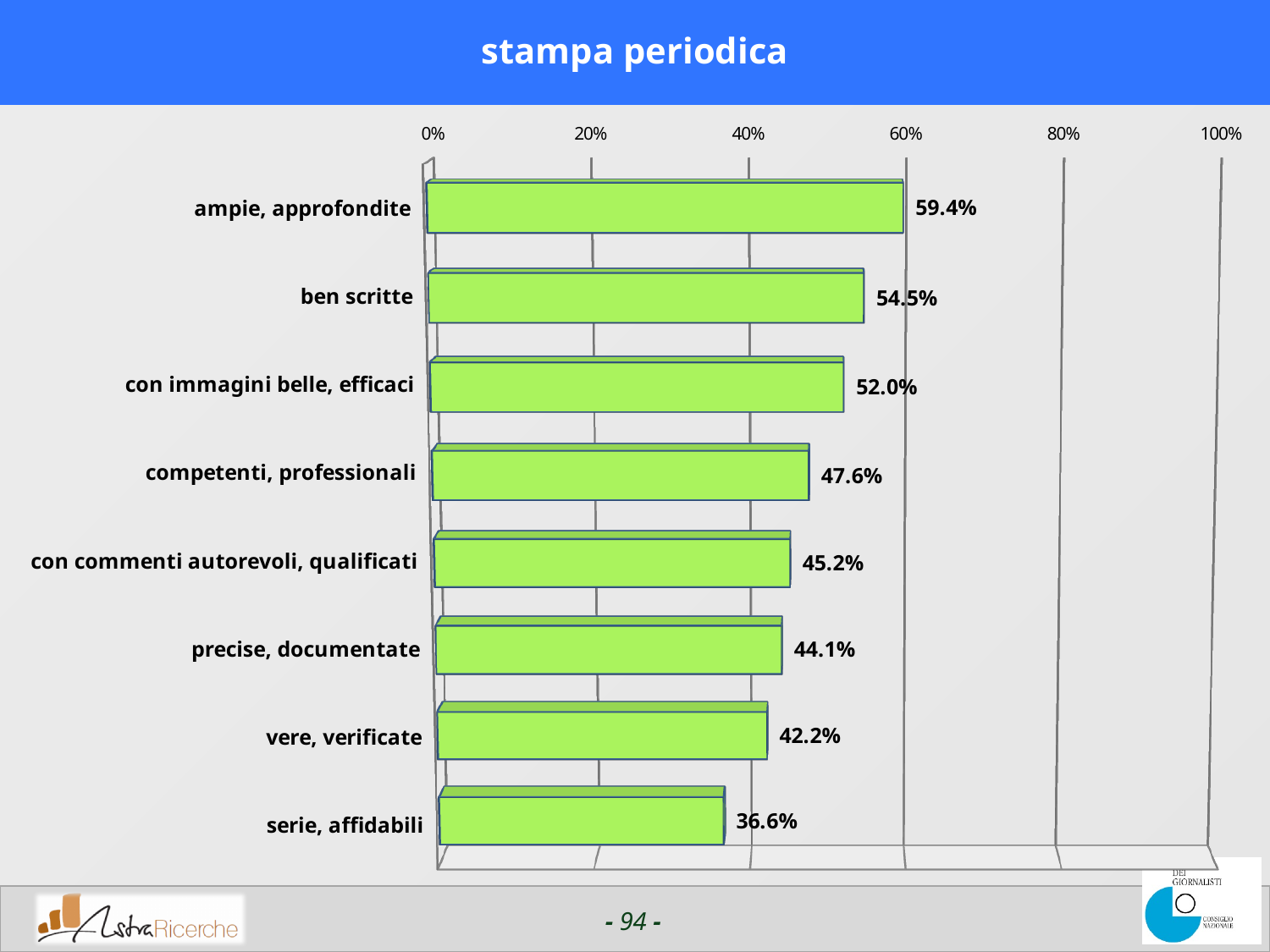
What is the value for "serie, affidabili"? 36.6% What is the difference between the values for "ben scritte" and "vere, verificate"? 12.3% Which category has the highest value? ampie, approfondite Which is larger, the value for "competenti, professionali" or the value for "con commenti autorevoli, qualificati"? competenti, professionali What is the title of the chart? stampa periodica Is the value for "ben scritte" greater or less than 60%? less What is the value for "ampie, approfondite"? 59.4% What kind of chart is shown on the slide? bar chart What is the value for "con immagini belle, efficaci"? 52.0% How many categories are shown in the chart? 8 Which category has the lowest value? serie, affidabili What is the value for "precise, documentate"? 44.1%